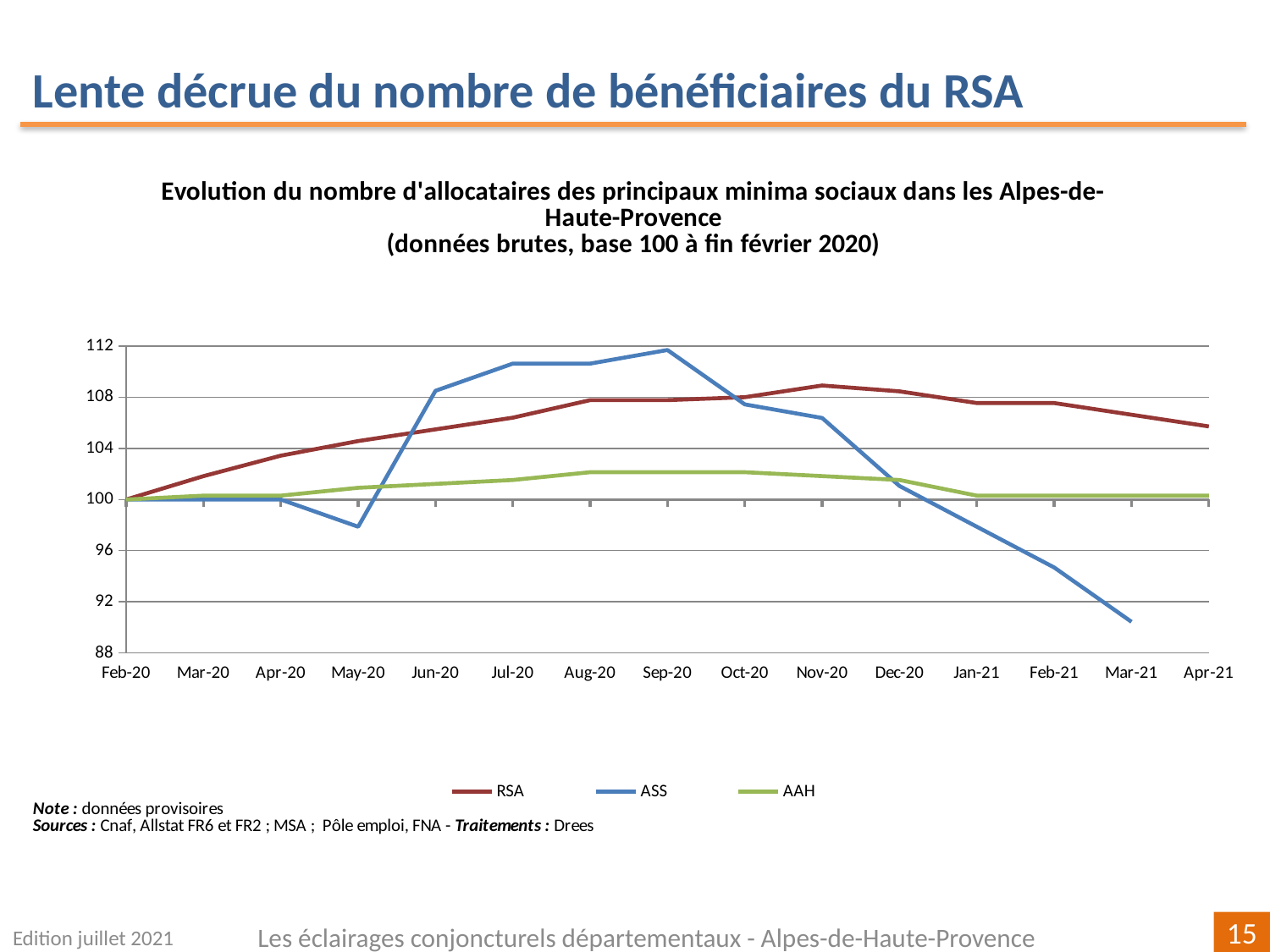
In which month does the ASS series reach its highest value? Sep-20 How many series does the legend list? 3 What colour is the line for the RSA series? Dark red In Mar-21, which series has the higher value, RSA or ASS? RSA Does the ASS series rise or fall between Sep-20 and Mar-21? Fall How many months are labelled along the x axis? 15 Is the value for ASS in May-20 greater or less than 100? less Is the value for RSA in Nov-20 greater or less than 108? greater Is the value for ASS in Sep-20 greater or less than 108? greater What kind of chart is shown on the slide? Line chart In Sep-20, which series has the higher value, ASS or AAH? ASS